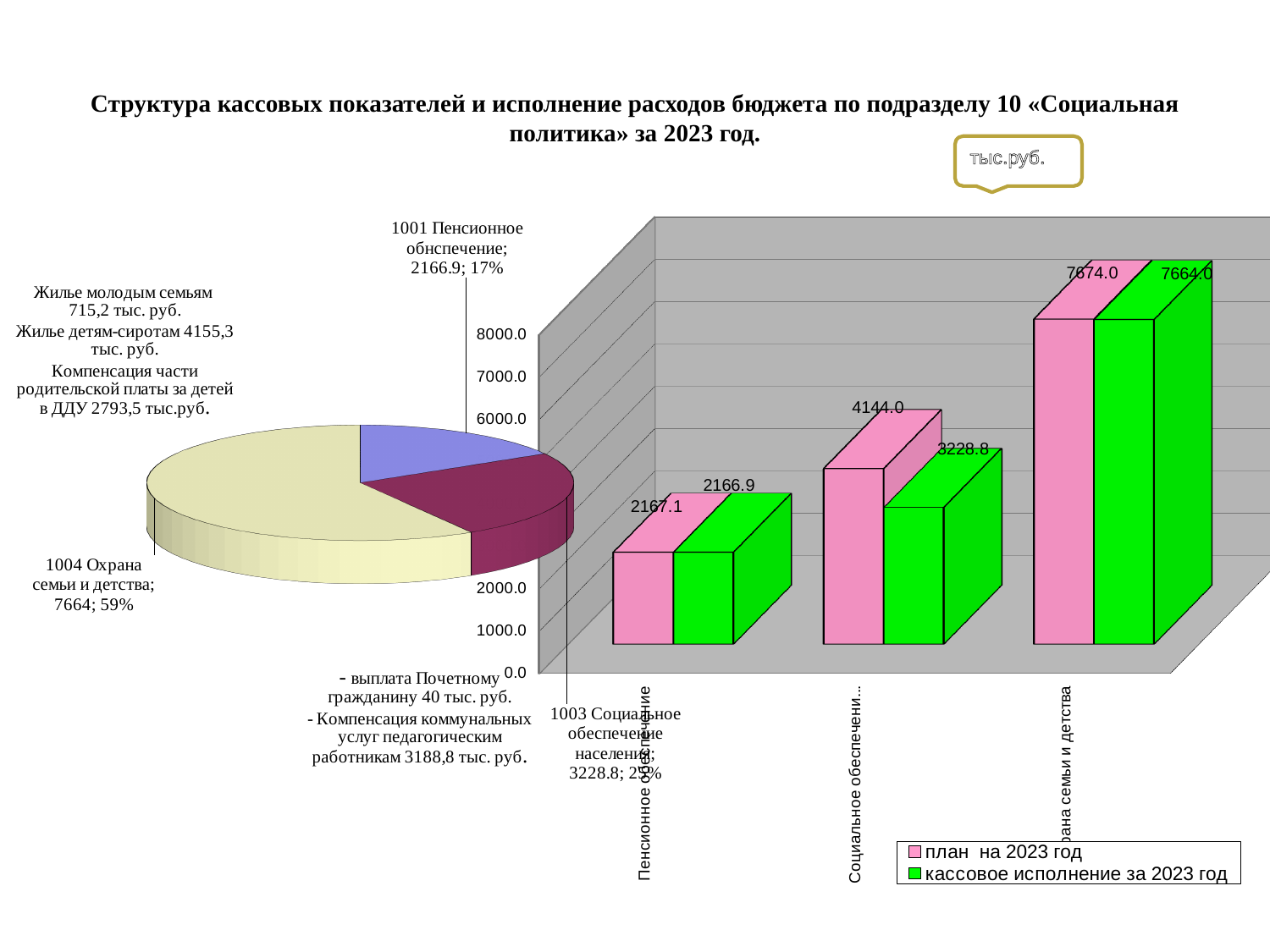
In the bar chart on the right, how many categories are shown on the x axis? 3 In the pie chart on the left, what share does '1004 Охрана семьи и детства' have? 59% In the bar chart on the right, which category has the highest 'кассовое исполнение за 2023 год' value? Охрана семьи и детства In the bar chart on the right, is the 'план на 2023 год' value for Социальное обеспечение larger or smaller than the 'кассовое исполнение за 2023 год' value for the same category? larger In the bar chart on the right, which category has the lowest 'план на 2023 год' value? Пенсионное обеспечение In the bar chart on the right, what is the value of 'план на 2023 год' for Пенсионное обеспечение? 2167.1 In the bar chart on the right, what is the difference between 'план на 2023 год' and 'кассовое исполнение за 2023 год' for Социальное обеспечение? 915.2 In the bar chart on the right, what is the value of 'план на 2023 год' for Социальное обеспечение? 4144.0 In the bar chart on the right, what is the value of 'кассовое исполнение за 2023 год' for Охрана семьи и детства? 7664.0 What kind of chart is the chart on the left of the slide? Pie chart In the bar chart on the right, how many series does the legend list? 2 In the pie chart on the left, what is the value shown for '1001 Пенсионное обеспечение'? 2166.9